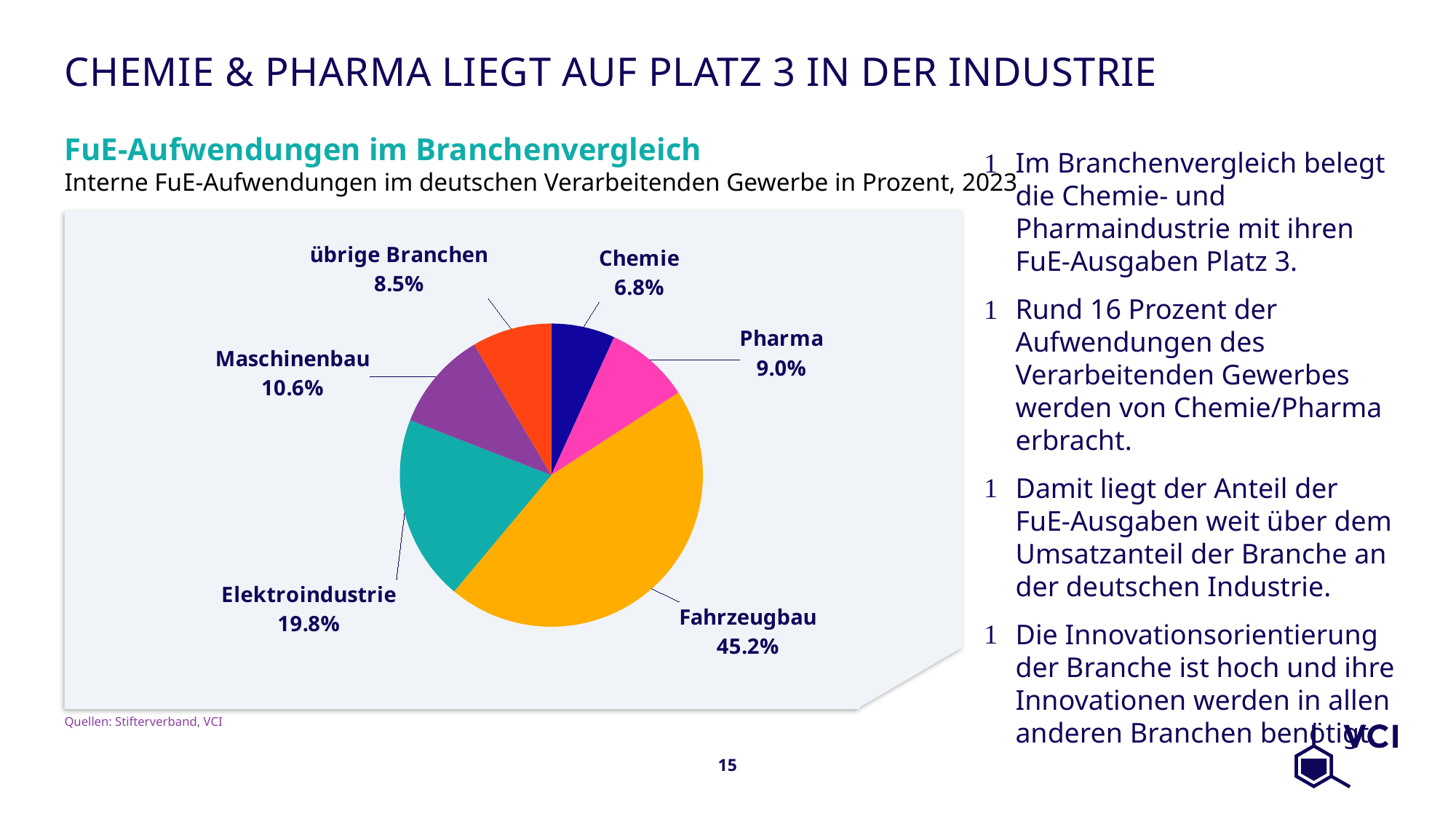
Which is larger, the share for Maschinenbau or the share for übrige Branchen? Maschinenbau What kind of chart is shown on the slide? pie chart What is the share for Fahrzeugbau? 45.2% How many slices does the pie chart have? 6 Which category has the largest share of the pie? Fahrzeugbau What is the difference between the shares of Elektroindustrie and Maschinenbau? 9.2% What is the share for Pharma? 9.0% What is the title of the chart? FuE-Aufwendungen im Branchenvergleich Which category has the smallest share of the pie? Chemie What is the share for Elektroindustrie? 19.8% What is the combined share of Chemie and Pharma? 15.8% What is the share for Chemie? 6.8%